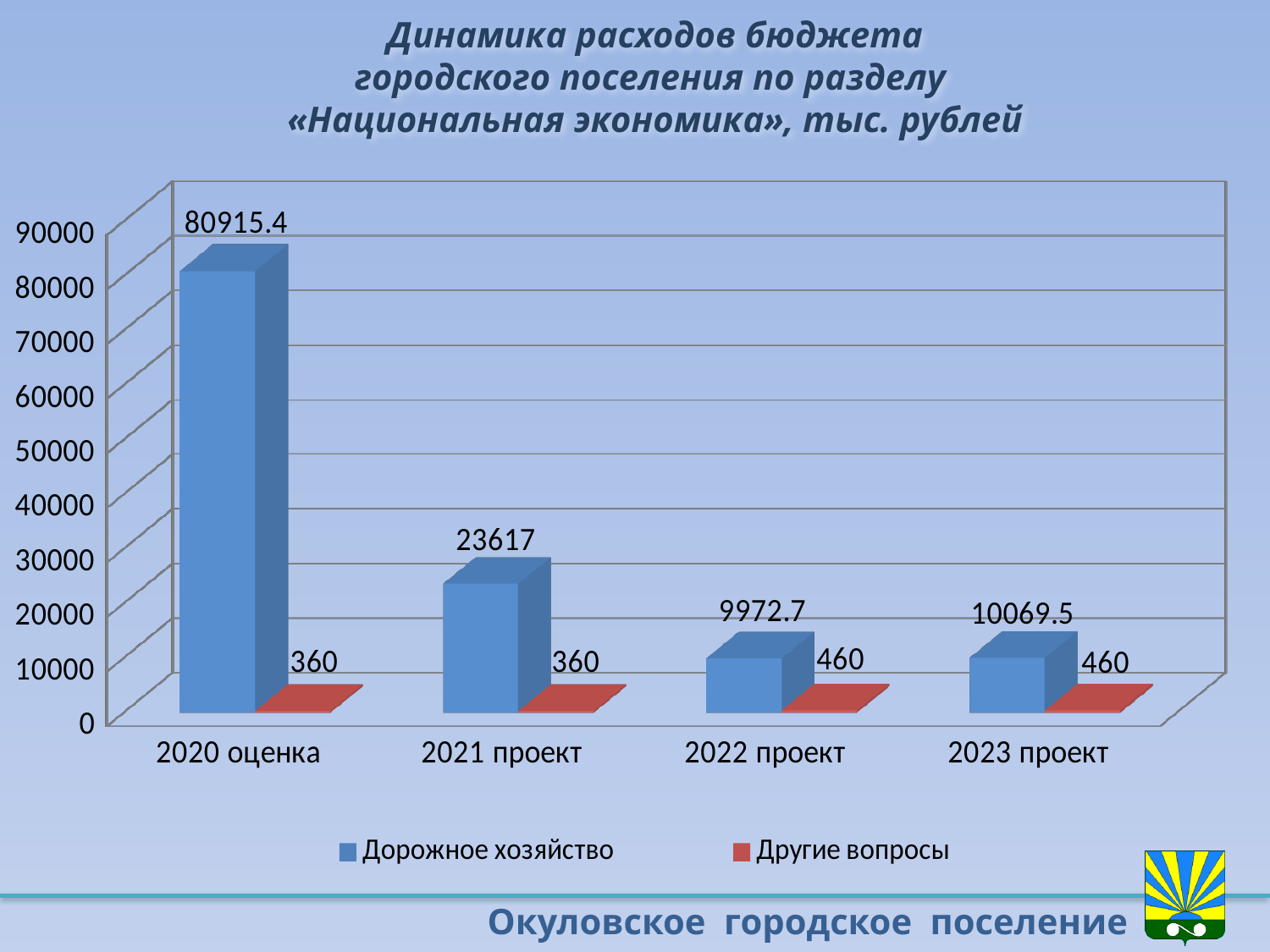
How many categories are shown on the x axis? 4 How many series does the legend list? 2 What is the value for Дорожное хозяйство in 2020 оценка? 80915.4 Is the value for Дорожное хозяйство in 2021 проект greater or less than 20000? greater Which colour represents Другие вопросы in the legend? red What kind of chart is shown on the slide? bar chart Which is larger: Дорожное хозяйство in 2022 проект or in 2023 проект? 2023 проект Which category has the lowest value for Дорожное хозяйство? 2022 проект What is the value for Дорожное хозяйство in 2021 проект? 23617 Which category has the highest value for Дорожное хозяйство? 2020 оценка What is the value for Другие вопросы in 2022 проект? 460 What is the difference between the Дорожное хозяйство values for 2020 оценка and 2021 проект? 57298.4